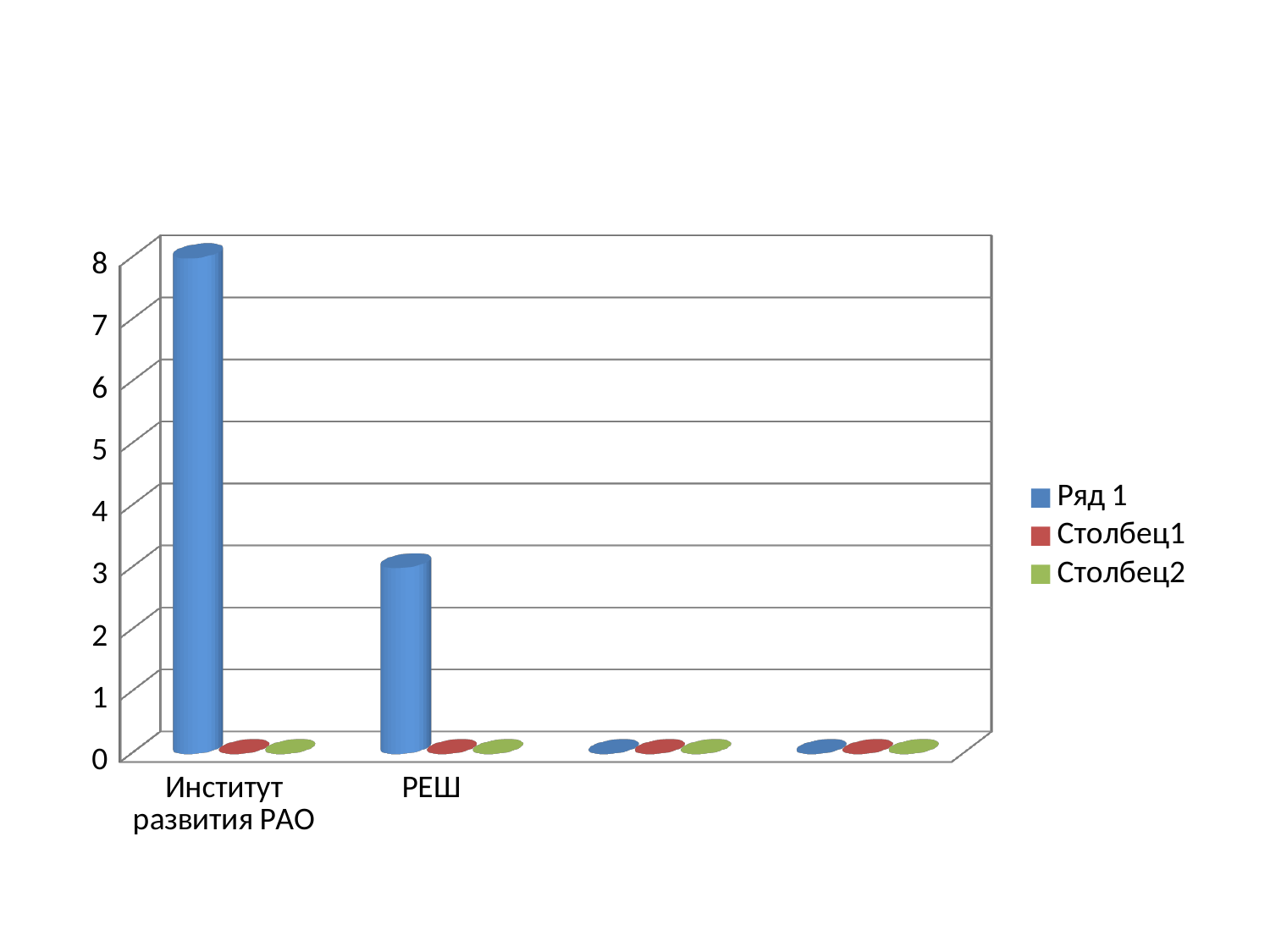
Which series is shown in blue? Ряд 1 What kind of chart is shown on the slide? bar chart How many series does the legend list? 3 Is the Ряд 1 value for Институт развития РАО greater or less than 7? greater Is the Ряд 1 value for РЕШ greater or less than 2? greater Is the Ряд 1 value for РЕШ greater or less than 5? less What is the name of the first series in the legend? Ряд 1 Which category has the highest value for Ряд 1? Институт развития РАО Which is larger for Ряд 1: Институт развития РАО or РЕШ? Институт развития РАО What is the highest value shown on the vertical axis? 8